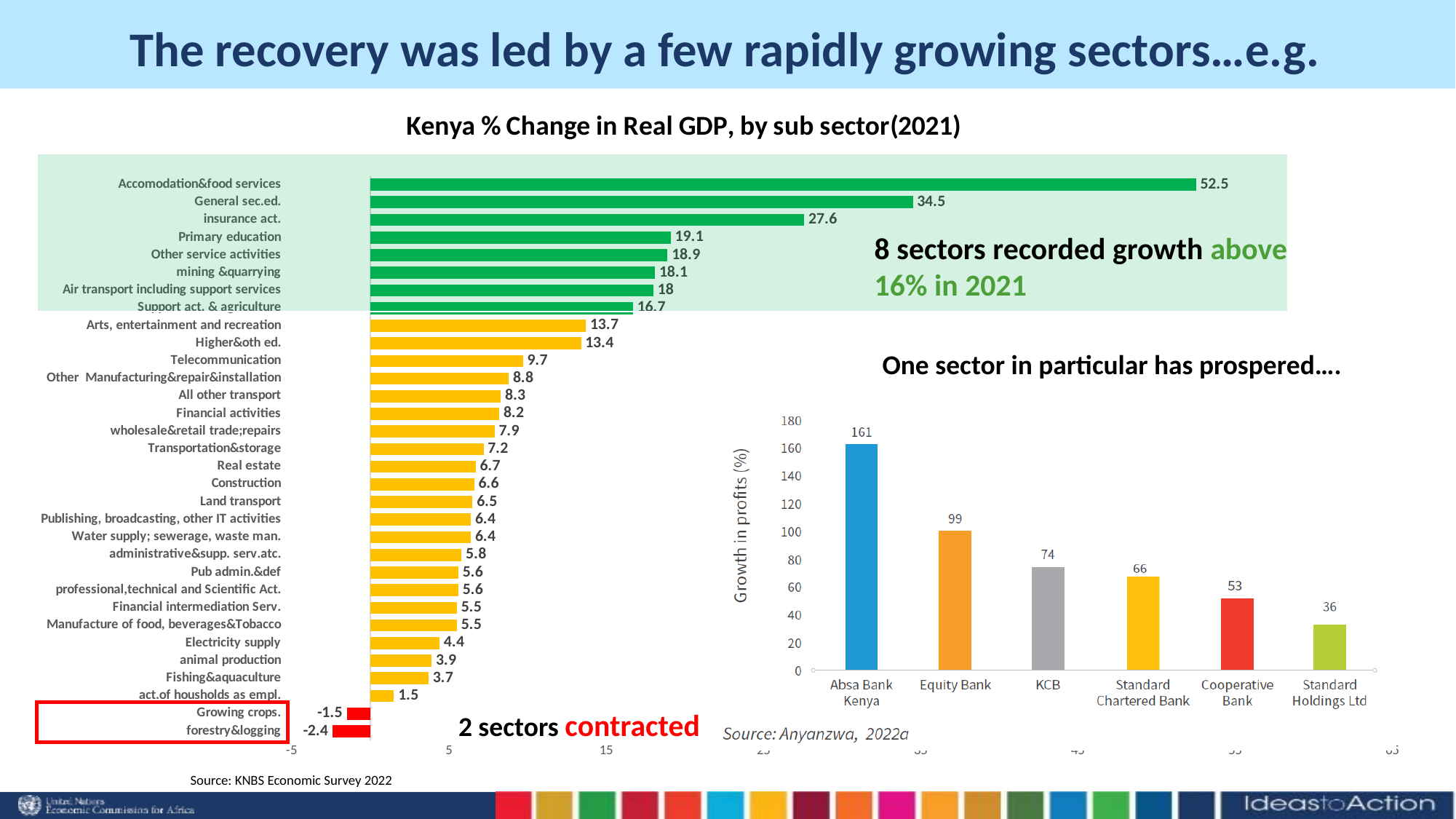
In the bank profit growth chart on the right, which bank has the highest growth in profits? Absa Bank Kenya In the Kenya % Change in Real GDP chart, what is the value for Telecommunication? 9.7 In the Kenya % Change in Real GDP chart, what is the value for Growing crops.? -1.5 In the Kenya % Change in Real GDP chart, which sub sector has the lowest value? forestry&logging In the bank profit growth chart on the right, how many banks are shown? 6 In the Kenya % Change in Real GDP chart, what is the difference between General sec.ed. and insurance act.? 6.9 In the Kenya % Change in Real GDP chart, how many sub sectors have a negative value? 2 In the bank profit growth chart on the right, what is the difference between Equity Bank and Standard Holdings Ltd? 63 In the Kenya % Change in Real GDP chart, which is larger: Real estate or Construction? Real estate In the Kenya % Change in Real GDP chart, what is the value for Accomodation&food services? 52.5 What type of chart is the chart on the right showing growth in profits? Bar chart In the bank profit growth chart on the right, what is the growth in profits for KCB? 74